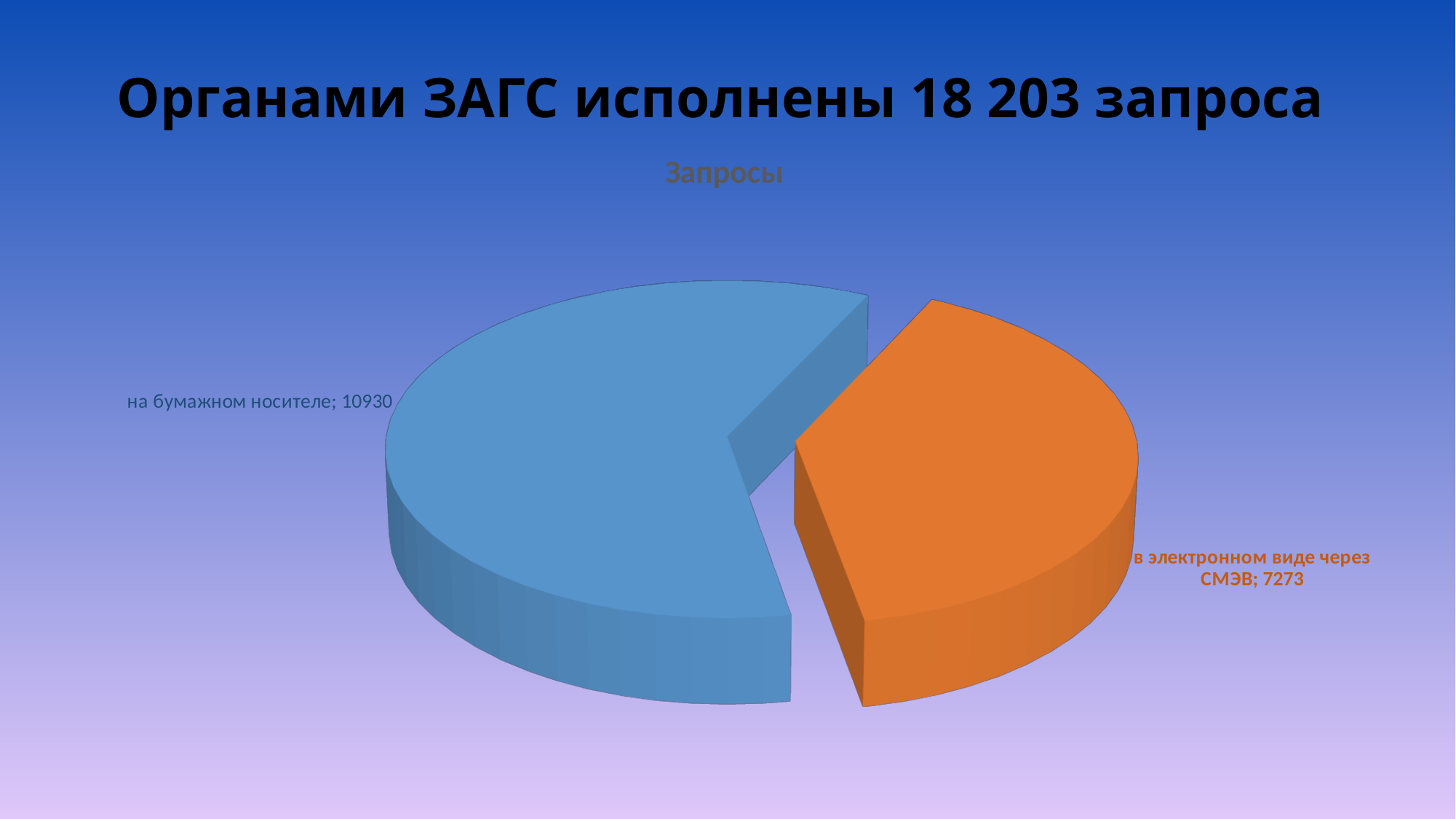
What share of the pie does 'на бумажном носителе' represent, rounded to the nearest whole percent? 60% What type of chart is shown on the slide? pie chart What colour is the slice for 'в электронном виде через СМЭВ'? orange How many slices does the pie chart have? 2 Which slice of the pie chart is the smallest? в электронном виде через СМЭВ What is the total of the two slices in the pie chart? 18203 What is the value for the slice 'на бумажном носителе' in the pie chart? 10930 Which slice of the pie chart is the largest? на бумажном носителе What is the title of the chart? Запросы Which is larger: 'на бумажном носителе' or 'в электронном виде через СМЭВ'? на бумажном носителе What is the difference between the values for 'на бумажном носителе' and 'в электронном виде через СМЭВ'? 3657 What is the value for the slice 'в электронном виде через СМЭВ' in the pie chart? 7273